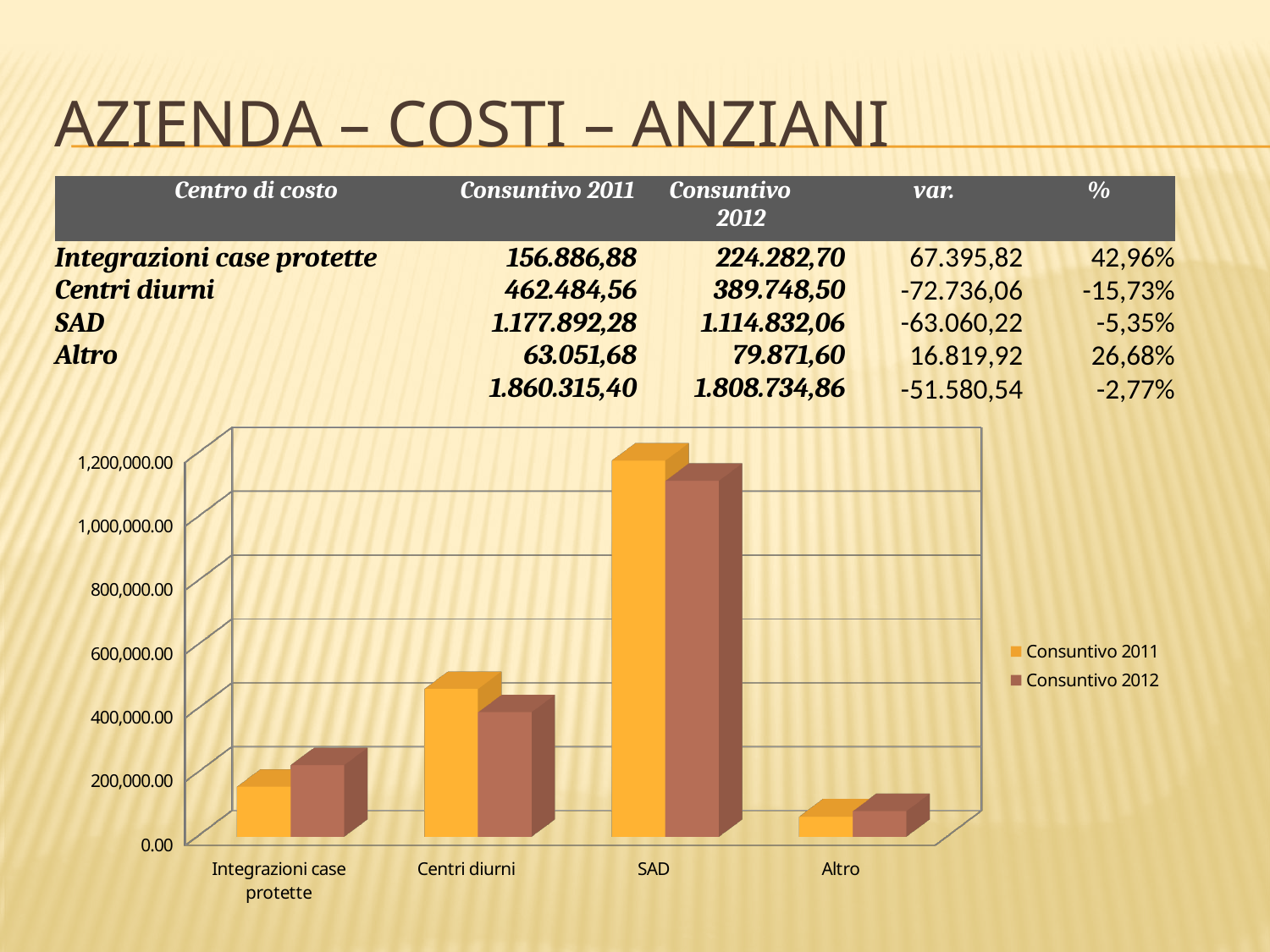
Is the Consuntivo 2011 value for SAD greater or less than 1,000,000.00? greater According to the table above the chart, what is the Consuntivo 2011 value for Centri diurni? 462.484,56 How many cost-centre categories are plotted on the x axis of the chart? 4 For Centri diurni, which is larger: Consuntivo 2011 or Consuntivo 2012? Consuntivo 2011 According to the table above the chart, what is the Consuntivo 2012 value for SAD? 1.114.832,06 What kind of chart is shown on the slide? bar chart Is the Consuntivo 2012 value for Altro greater or less than 200,000.00? less How many series does the chart legend list? 2 For Integrazioni case protette, which is larger: Consuntivo 2011 or Consuntivo 2012? Consuntivo 2012 Which category has the highest Consuntivo 2011 value in the chart? SAD Which category has the lowest Consuntivo 2012 value in the chart? Altro What are the two entries in the chart legend? Consuntivo 2011 and Consuntivo 2012